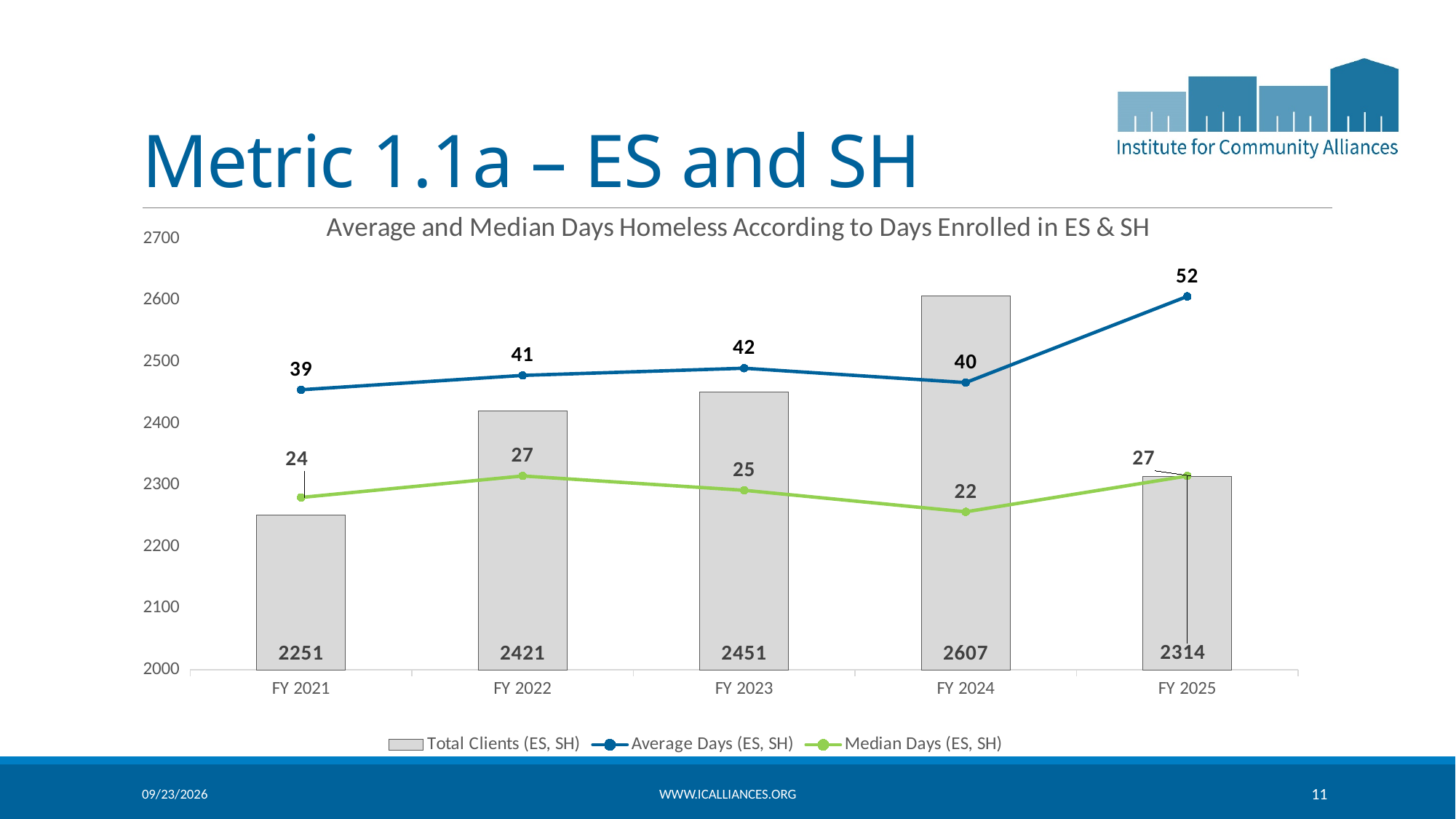
Is the Total Clients (ES, SH) bar for FY 2022 greater or less than 2400? greater Which fiscal year has the lowest Median Days (ES, SH)? FY 2024 What is the title of the chart? Average and Median Days Homeless According to Days Enrolled in ES & SH What is the value of Total Clients (ES, SH) for FY 2024? 2607 How many series does the legend list? 3 How many fiscal years are shown on the x axis? 5 What is the Median Days (ES, SH) value for FY 2022? 27 Which fiscal year has the highest Total Clients (ES, SH)? FY 2024 Which is larger, the Average Days (ES, SH) for FY 2023 or for FY 2024? FY 2023 What kind of chart is this? Combined bar and line chart What is the Average Days (ES, SH) value for FY 2025? 52 What is the difference in Total Clients (ES, SH) between FY 2024 and FY 2025? 293